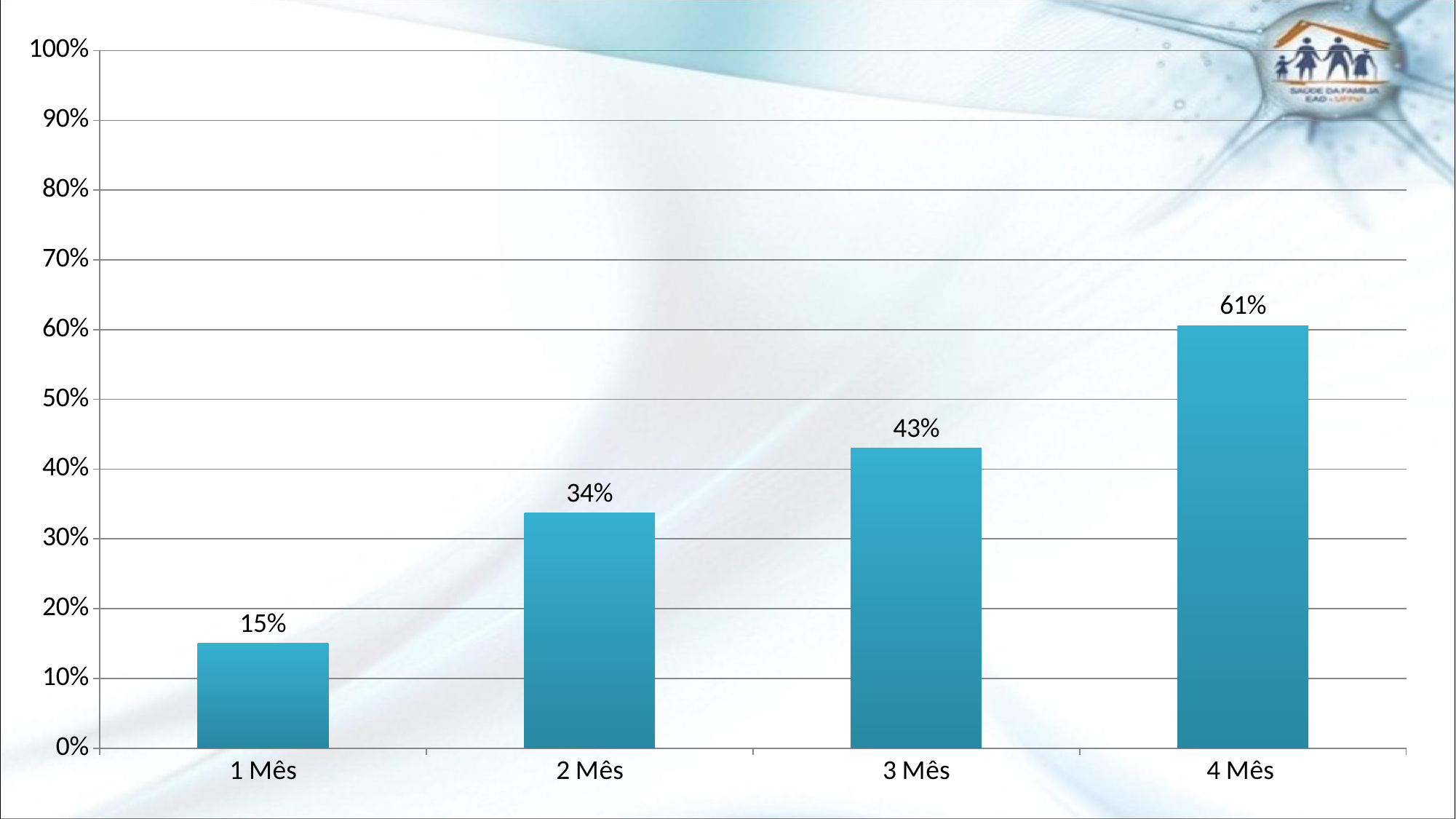
Which is larger, the value for 2 Mês or the value for 3 Mês? 3 Mês How many categories are shown on the x axis? 4 What is the value for 1 Mês? 15% Which category has the lowest value? 1 Mês What is the value for 3 Mês? 43% Which category has the highest value? 4 Mês What is the difference between the values for 3 Mês and 2 Mês? 9% What is the value for 4 Mês? 61% What is the difference between the values for 4 Mês and 1 Mês? 46% Do the values rise or fall from 1 Mês to 4 Mês? Rise What kind of chart is shown on the slide? Bar chart What is the value for 2 Mês? 34%